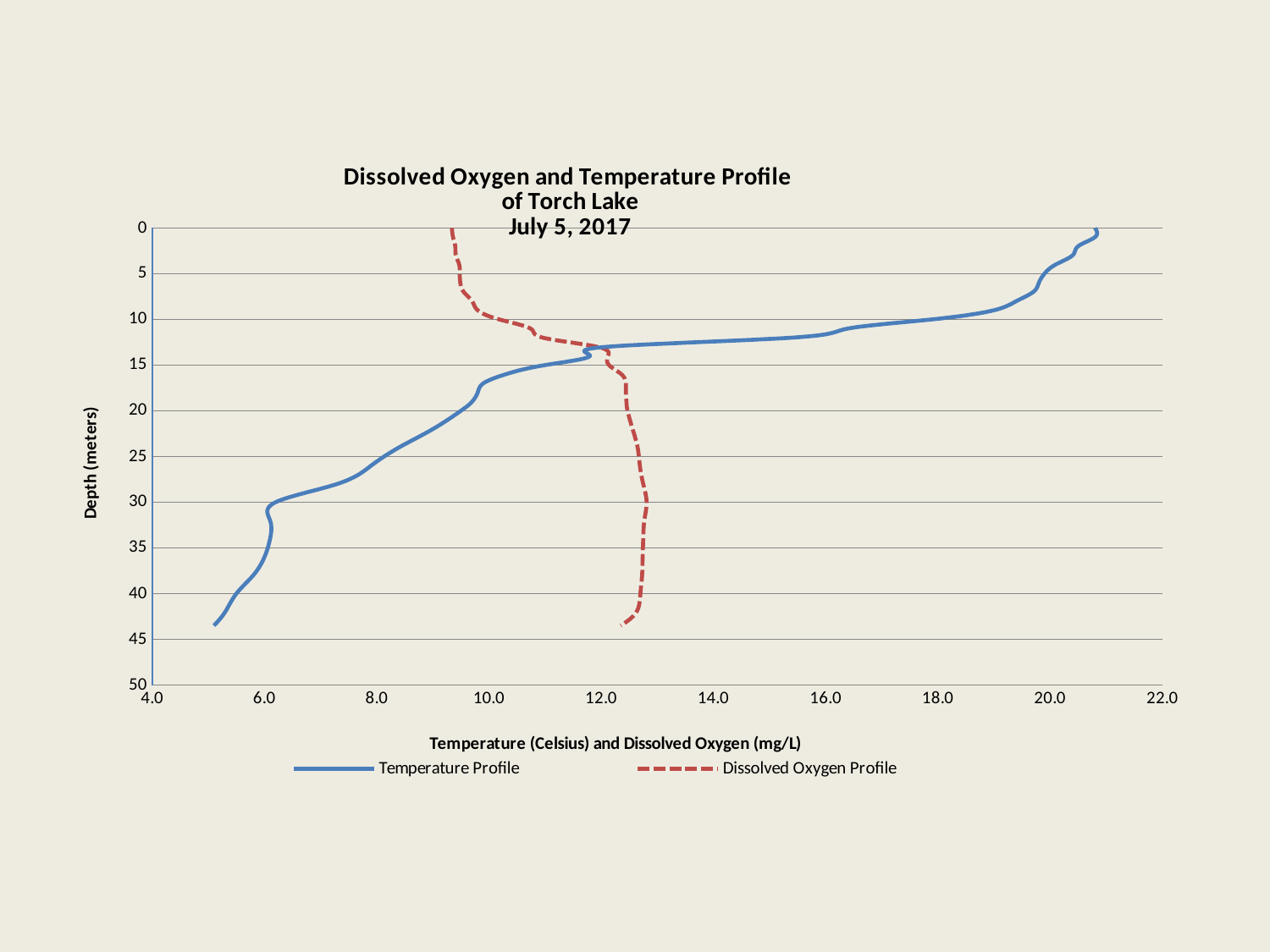
At a depth of 0 meters, which series has the larger value, Temperature Profile or Dissolved Oxygen Profile? Temperature Profile Is the Temperature Profile value at a depth of 10 meters greater or less than 16? greater How many series does the legend list? 2 Is the Temperature Profile value at a depth of 0 meters greater or less than 20? greater What kind of chart is shown on the slide? line chart What is the label of the vertical axis? Depth (meters) At a depth of 40 meters, which series has the larger value, Temperature Profile or Dissolved Oxygen Profile? Dissolved Oxygen Profile Is the Dissolved Oxygen Profile value at a depth of 0 meters greater or less than 10? less As depth increases from 0 to 45 meters, does the Temperature Profile rise or fall? fall What is the title of the chart? Dissolved Oxygen and Temperature Profile of Torch Lake July 5, 2017